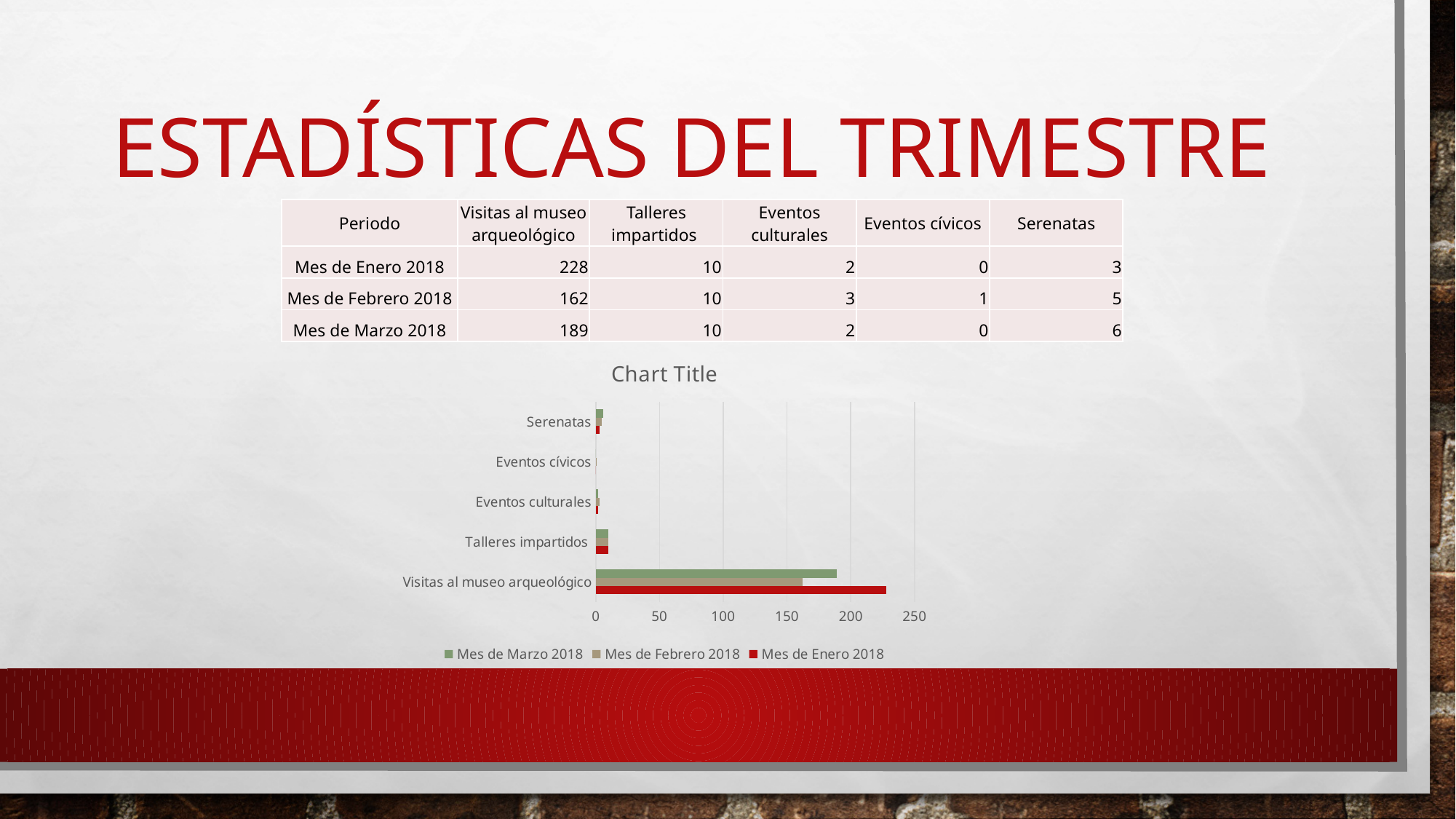
Which category has the shortest bars in the chart? Eventos cívicos How many categories are shown on the chart's vertical axis? 5 What kind of chart is shown on the slide? bar chart How many series does the chart legend list? 3 Is the value for Talleres impartidos in Mes de Marzo 2018 greater or less than 50? less What is the title shown above the chart? Chart Title Which category has the longest bars in the chart? Visitas al museo arqueológico According to the slide, what is the value of Visitas al museo arqueológico for Mes de Marzo 2018? 189 For Visitas al museo arqueológico, which series has the larger value: Mes de Enero 2018 or Mes de Marzo 2018? Mes de Enero 2018 Is the value for Visitas al museo arqueológico in Mes de Febrero 2018 greater or less than 150? greater Is the value for Visitas al museo arqueológico in Mes de Enero 2018 greater or less than 200? greater What is the difference between Visitas al museo arqueológico in Mes de Enero 2018 and Mes de Febrero 2018, using the values printed on the slide? 66